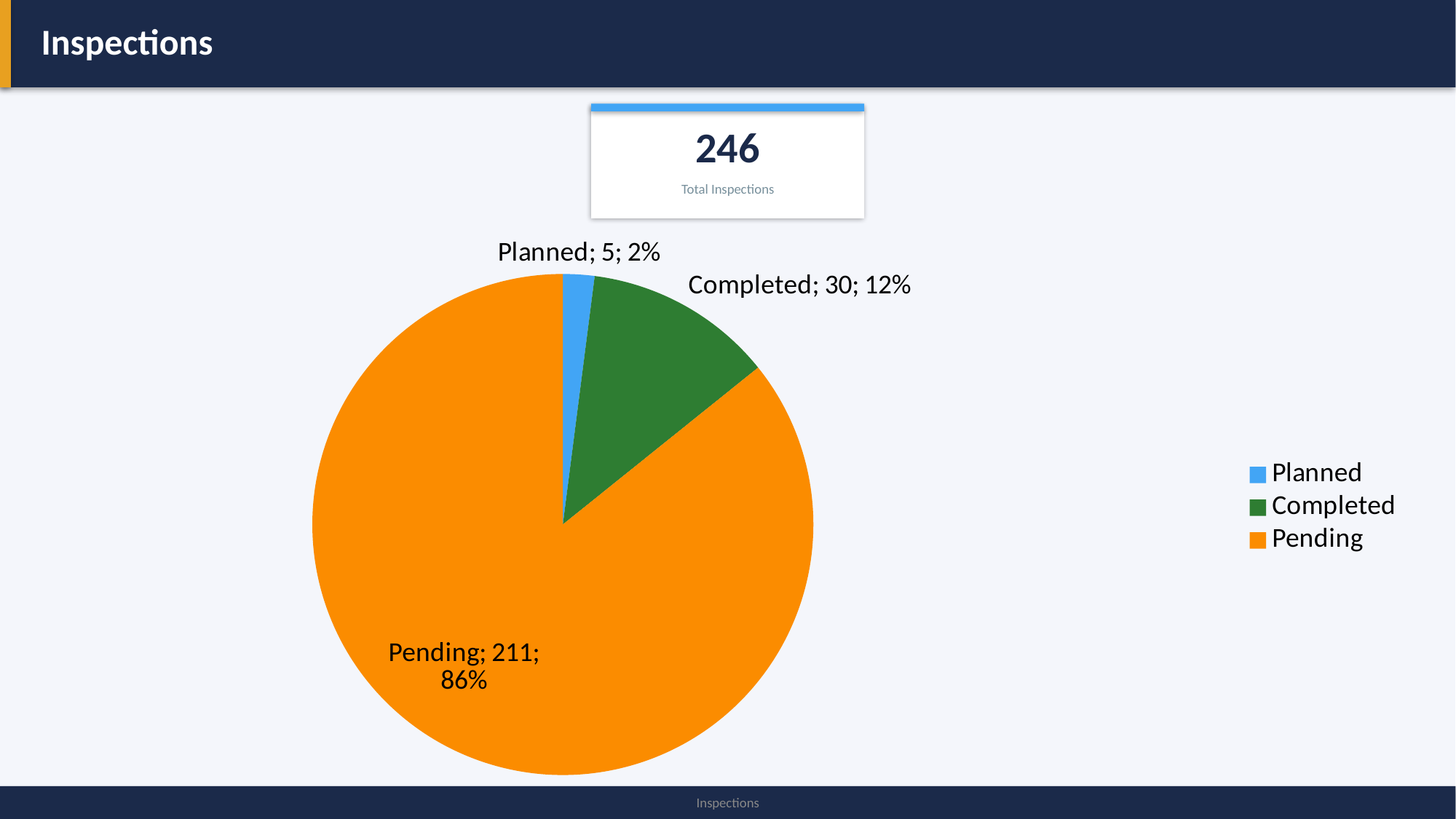
What share of the pie does Completed represent? 12% What colour is the Completed slice? green Which category has the largest slice? Pending What is the difference between the Pending and Completed values? 181 How many entries does the legend list? 3 How many slices does the pie chart have? 3 What kind of chart is shown on the slide? pie chart What share of the pie does Pending represent? 86% Which category has the smallest slice? Planned What is the value for Planned? 5 What is the value for Pending? 211 What is the value for Completed? 30